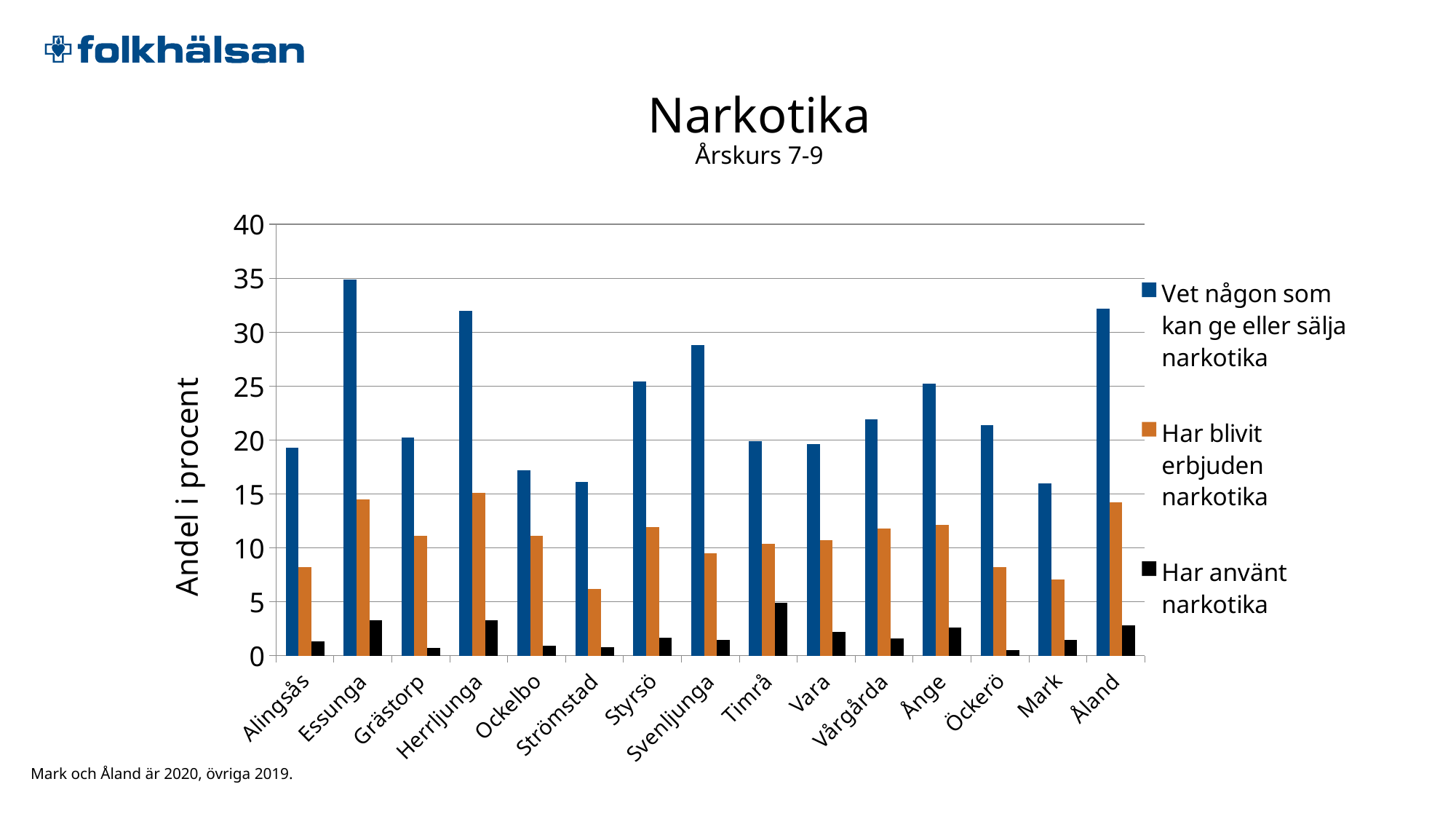
How many series does the legend list? 3 Which municipality has the highest value for 'Vet någon som kan ge eller sälja narkotika'? Essunga Is the value for Strömstad in the series 'Har blivit erbjuden narkotika' greater or less than 5? greater Is the value for Essunga in the series 'Vet någon som kan ge eller sälja narkotika' greater or less than 30? greater What is the label of the y axis? Andel i procent Which is larger for 'Vet någon som kan ge eller sälja narkotika': Styrsö or Svenljunga? Svenljunga Is the value for Ockelbo in the series 'Vet någon som kan ge eller sälja narkotika' greater or less than 15? greater What kind of chart is shown on the slide? bar chart How many municipalities (categories) are shown on the x axis? 15 Which is larger for 'Har använt narkotika': Timrå or Vara? Timrå Which municipality has the highest value for 'Har använt narkotika'? Timrå